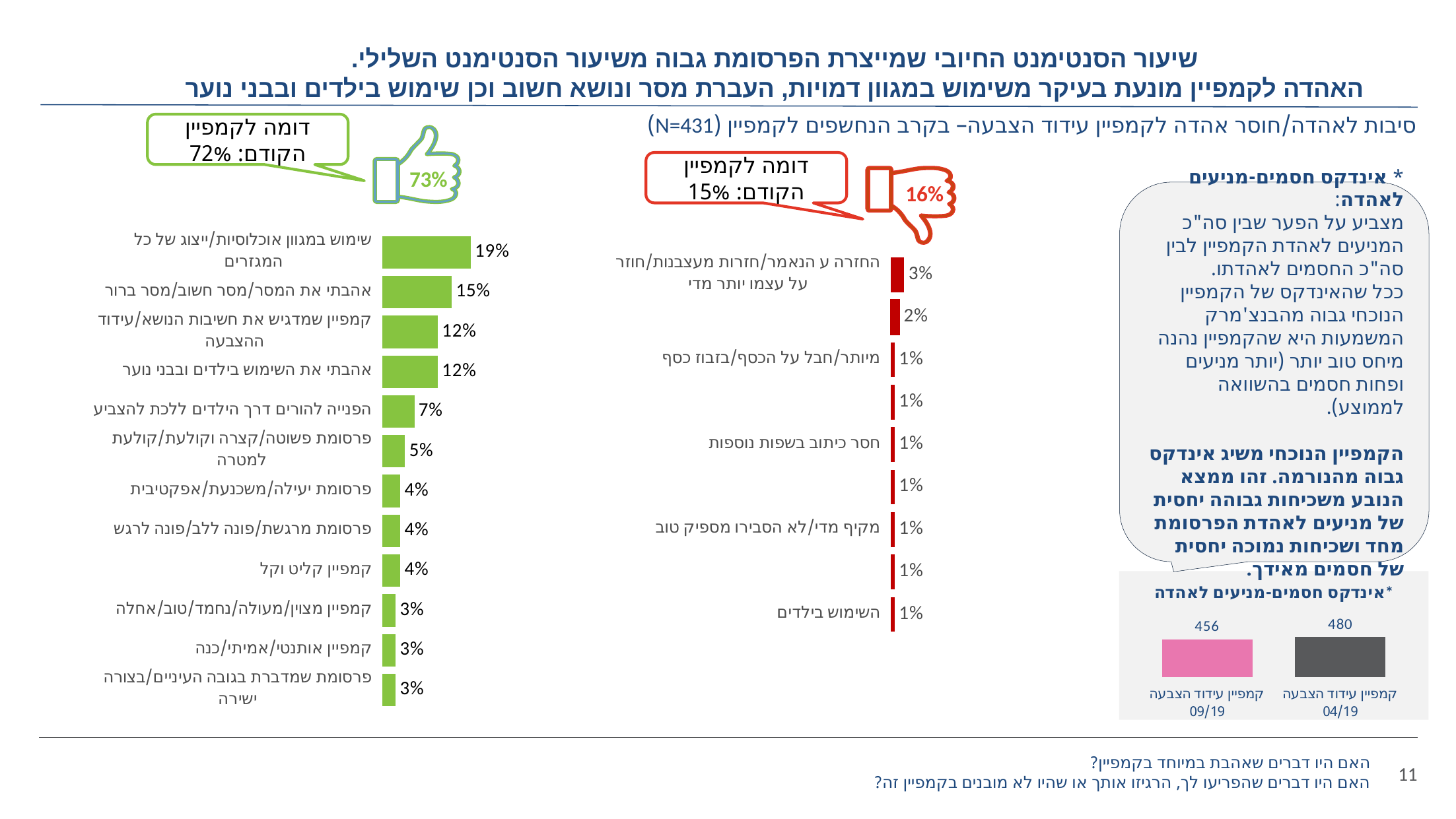
In the red bar chart in the middle, what is the value for "השימוש בילדים"? 1% In the red bar chart in the middle, which category has the highest value? החזרה על הנאמר/חזרות מעצבנות/חוזר על עצמו יותר מדי How many categories are shown in the green bar chart on the left? 12 In the red bar chart in the middle, what is the value for "החזרה על הנאמר/חזרות מעצבנות/חוזר על עצמו יותר מדי"? 3% In the green bar chart on the left, what is the value for "הפנייה להורים דרך הילדים ללכת להצביע"? 7% In the green bar chart on the left, which is larger: "אהבתי את השימוש בילדים ובבני נוער" or "קמפיין קליט וקל"? אהבתי את השימוש בילדים ובבני נוער In the green bar chart on the left, what is the value for "שימוש במגוון אוכלוסיות/ייצוג של כל המגזרים"? 19% In the green bar chart on the left, which category has the highest value? שימוש במגוון אוכלוסיות/ייצוג של כל המגזרים In the index chart at the bottom right (אינדקס חסמים-מניעים לאהדה), what is the difference between the 04/19 and 09/19 campaign values? 24 In the green bar chart on the left, what is the difference between "אהבתי את המסר/מסר חשוב/מסר ברור" and "פרסומת פשוטה/קצרה וקולעת/קולעת למטרה"? 10 percentage points What type of chart is the green chart on the left? Bar chart In the index chart at the bottom right (אינדקס חסמים-מניעים לאהדה), what is the value for "קמפיין עידוד הצבעה 09/19"? 456